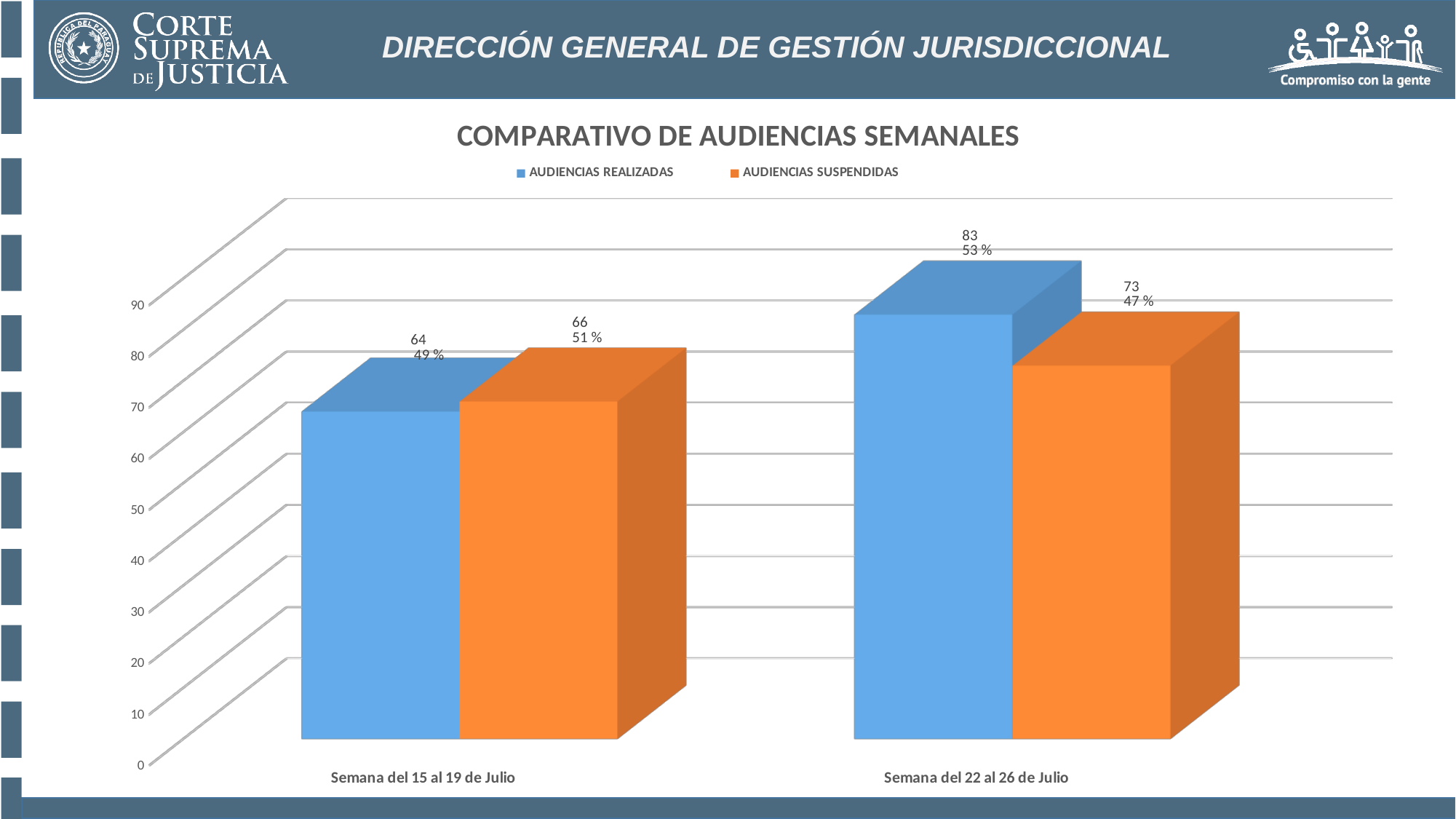
What percentage is shown for AUDIENCIAS REALIZADAS in Semana del 22 al 26 de Julio? 53 % How many weeks (categories) are shown on the x axis? 2 What is the difference between AUDIENCIAS REALIZADAS in Semana del 22 al 26 de Julio and Semana del 15 al 19 de Julio? 19 What kind of chart is shown on the slide? Bar chart What percentage is shown for AUDIENCIAS SUSPENDIDAS in Semana del 15 al 19 de Julio? 51 % What is the title of the chart? COMPARATIVO DE AUDIENCIAS SEMANALES Which week has the lowest value for AUDIENCIAS SUSPENDIDAS? Semana del 15 al 19 de Julio What is the value of AUDIENCIAS REALIZADAS for Semana del 15 al 19 de Julio? 64 How many series does the legend list? 2 In Semana del 22 al 26 de Julio, which is larger: AUDIENCIAS REALIZADAS or AUDIENCIAS SUSPENDIDAS? AUDIENCIAS REALIZADAS What is the value of AUDIENCIAS SUSPENDIDAS for Semana del 22 al 26 de Julio? 73 Which week has the highest value for AUDIENCIAS REALIZADAS? Semana del 22 al 26 de Julio